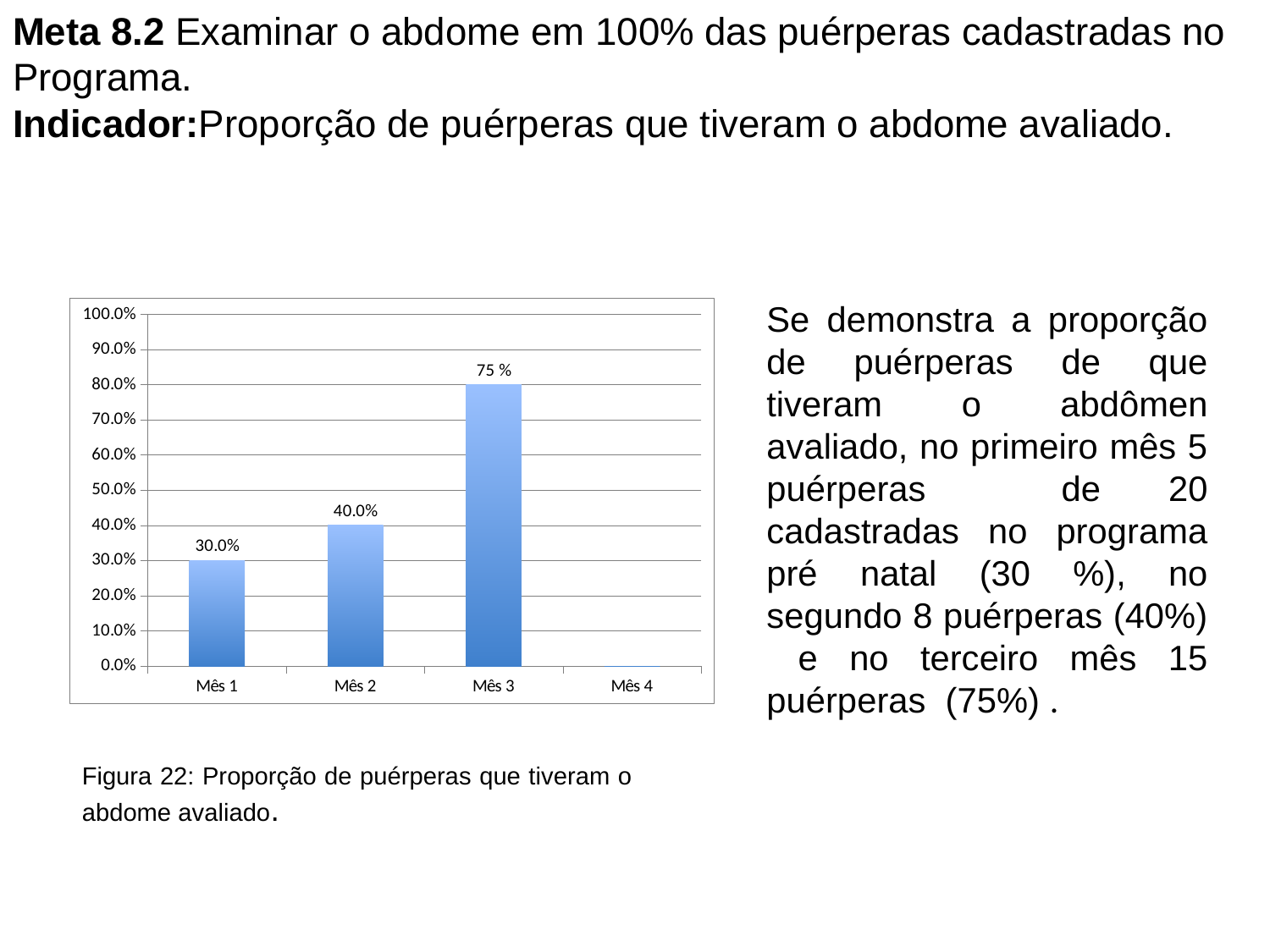
What data label is printed above the bar for Mês 3? 75 % Is the value for Mês 1 greater or less than 50.0%? less Among the months with a bar shown, which has the lowest value? Mês 1 Is the value for Mês 3 greater or less than 60.0%? greater What is the value shown for Mês 2? 40.0% What is the value shown for Mês 1? 30.0% What is the difference between the values for Mês 2 and Mês 1? 10.0% What kind of chart is shown? bar chart Which month has the highest bar? Mês 3 Which month category has no bar plotted? Mês 4 How many month categories are shown on the x axis? 4 Which is larger, the value for Mês 1 or the value for Mês 2? Mês 2